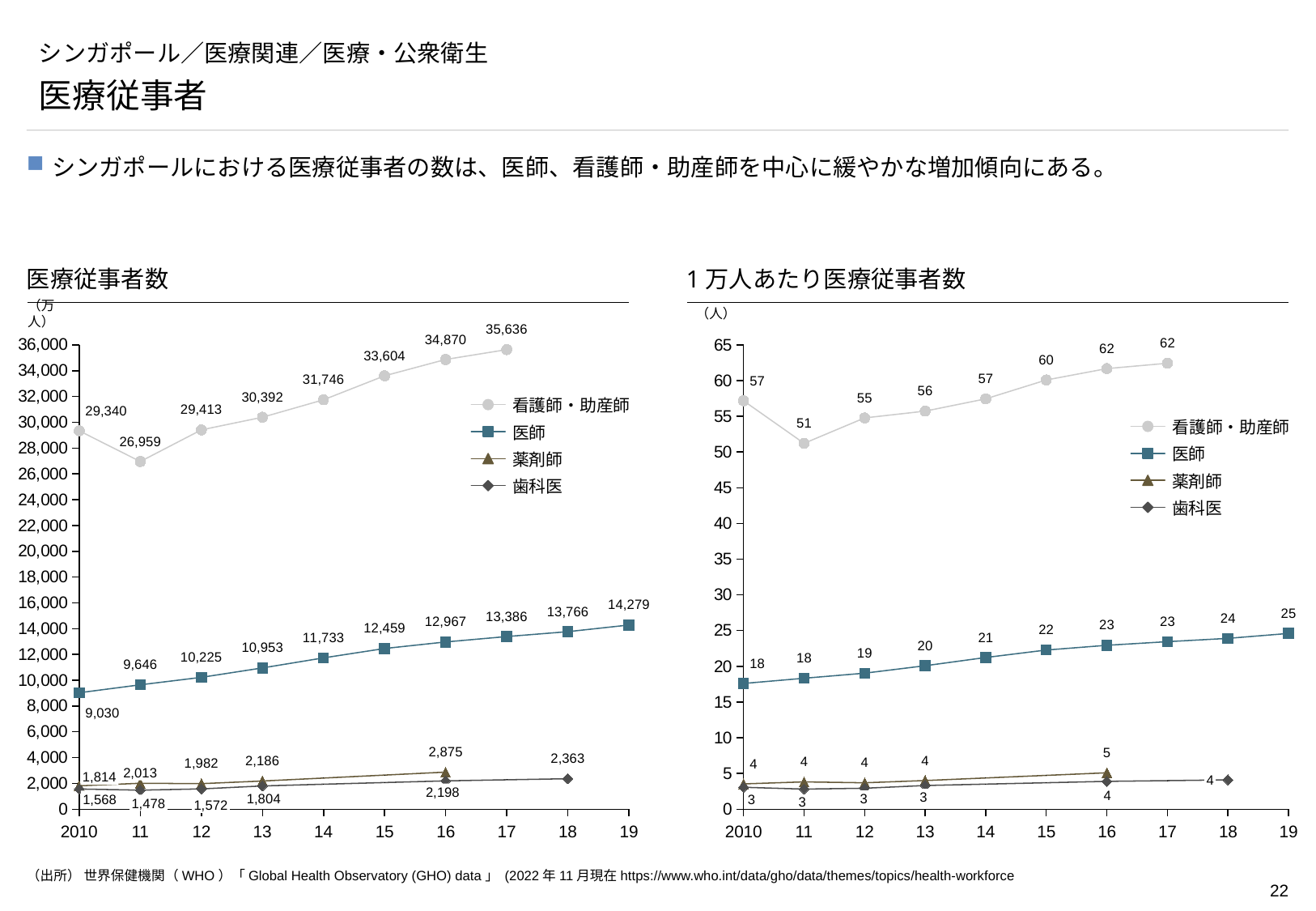
In the 医療従事者数 chart on the left, is the value for 医師 in 2015 greater or less than 12,000? greater In the 1万人あたり医療従事者数 chart on the right, what is the value for 看護師・助産師 in 2011? 51 In the 医療従事者数 chart on the left, what is the difference between the 医師 values in 2019 and 2010? 5,249 In the 医療従事者数 chart on the left, what is the value for 医師 in 2010? 9,030 In the 1万人あたり医療従事者数 chart on the right, does the 医師 series generally rise or fall from 2010 to 2019? rise In the 医療従事者数 chart on the left, which year has the lowest value for 看護師・助産師? 2011 In the 医療従事者数 chart on the left, how many series does the legend list? 4 In the 医療従事者数 chart on the left, what is the value for 薬剤師 in 2016? 2,875 In the 1万人あたり医療従事者数 chart on the right, what is the value for 医師 in 2019? 25 In the 1万人あたり医療従事者数 chart on the right, which is larger in 2016: 薬剤師 or 歯科医? 薬剤師 What type of chart is the 1万人あたり医療従事者数 chart on the right? line chart